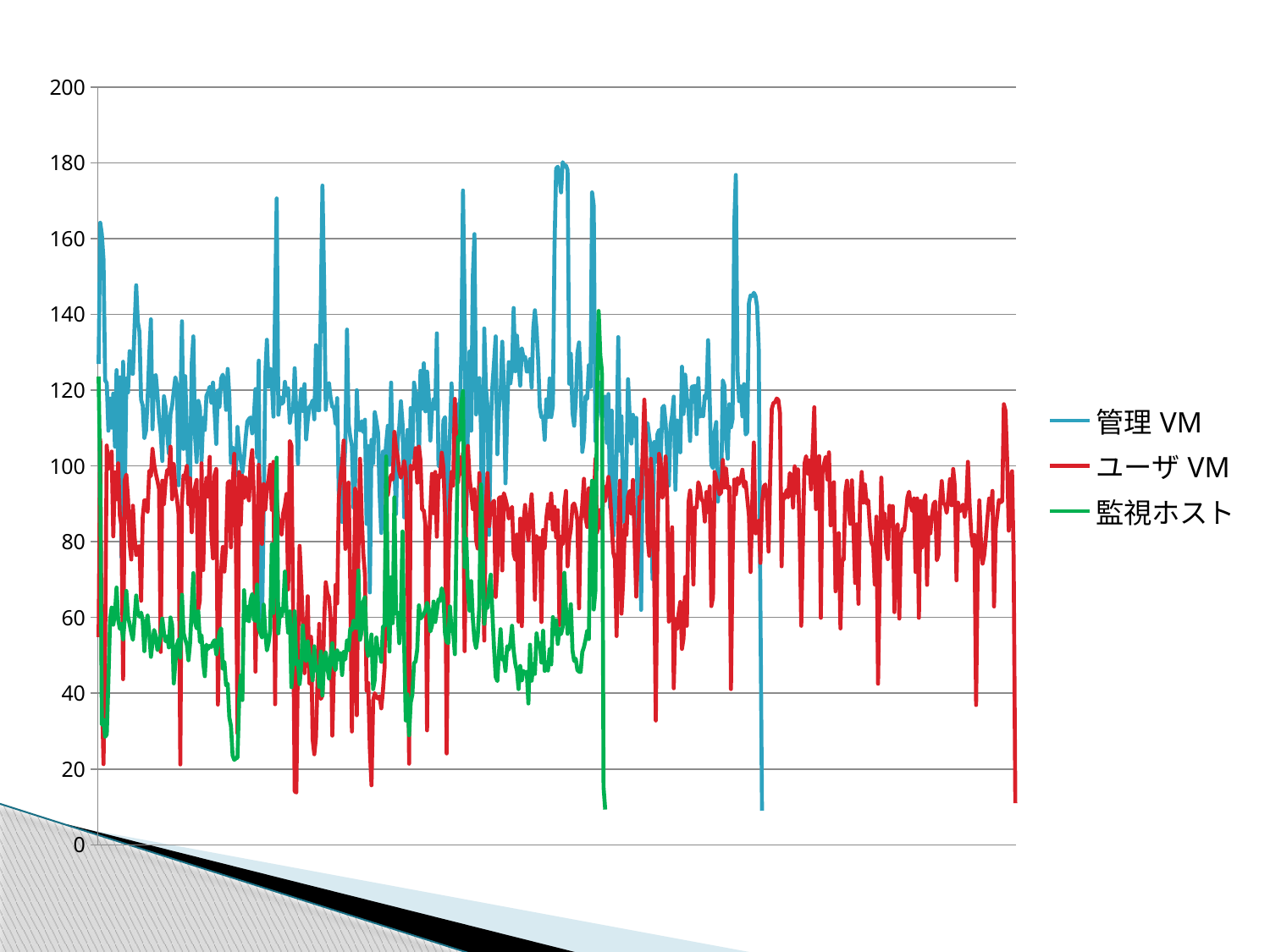
Which series extends furthest to the right along the x axis? ユーザ VM How many series does the legend list? 3 Which series is plotted with the blue line? 管理 VM Which series generally has higher values, ユーザ VM or 監視ホスト? ユーザ VM What kind of chart is shown on the slide? line chart Is the highest peak of the ユーザ VM series greater or less than 140? less Which series generally has the highest values across the chart? 管理 VM Is the highest peak of the 管理 VM series greater or less than 160? greater Is the highest peak of the 監視ホスト series greater or less than 160? less What is the maximum value shown on the vertical axis? 200 Which series generally has the lowest values across the chart? 監視ホスト